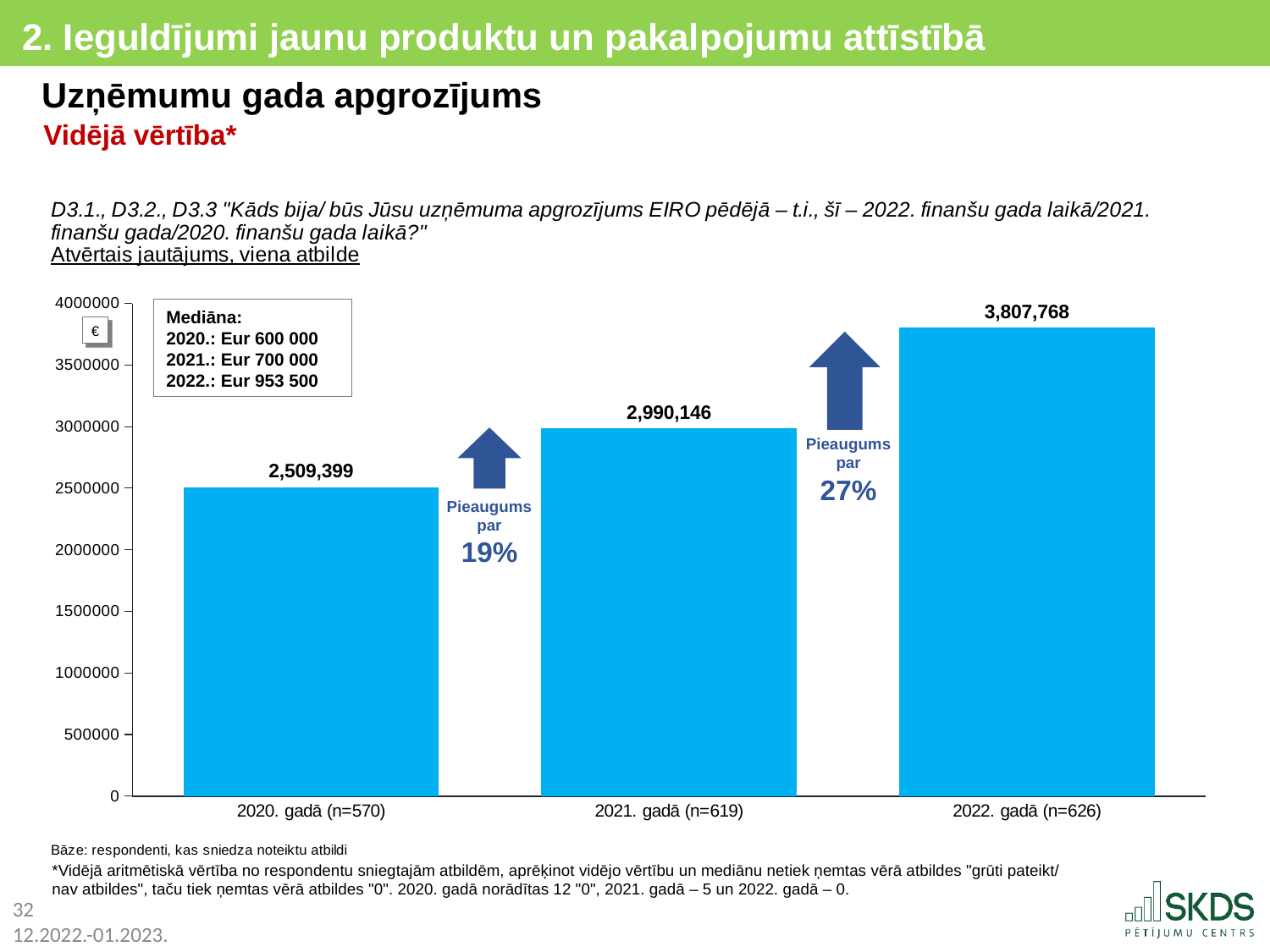
Which year has the highest average turnover in the chart? 2022. gadā (n=626) What is the difference between the 2021 and 2020 average turnover values? 480,747 What kind of chart is shown on the slide? bar chart What is the average annual turnover value shown for 2021. gadā (n=619)? 2,990,146 Is the value for 2020. gadā (n=570) greater or less than 3000000? less What is the average annual turnover value shown for 2022. gadā (n=626)? 3,807,768 What percentage increase is annotated between 2021 and 2022? 27% What is the average annual turnover value shown for 2020. gadā (n=570)? 2,509,399 How many years (categories) are shown in the chart? 3 Which is larger, the average turnover for 2021 or for 2022? 2022 What is the difference between the 2022 and 2021 average turnover values? 817,622 Which year has the lowest average turnover in the chart? 2020. gadā (n=570)